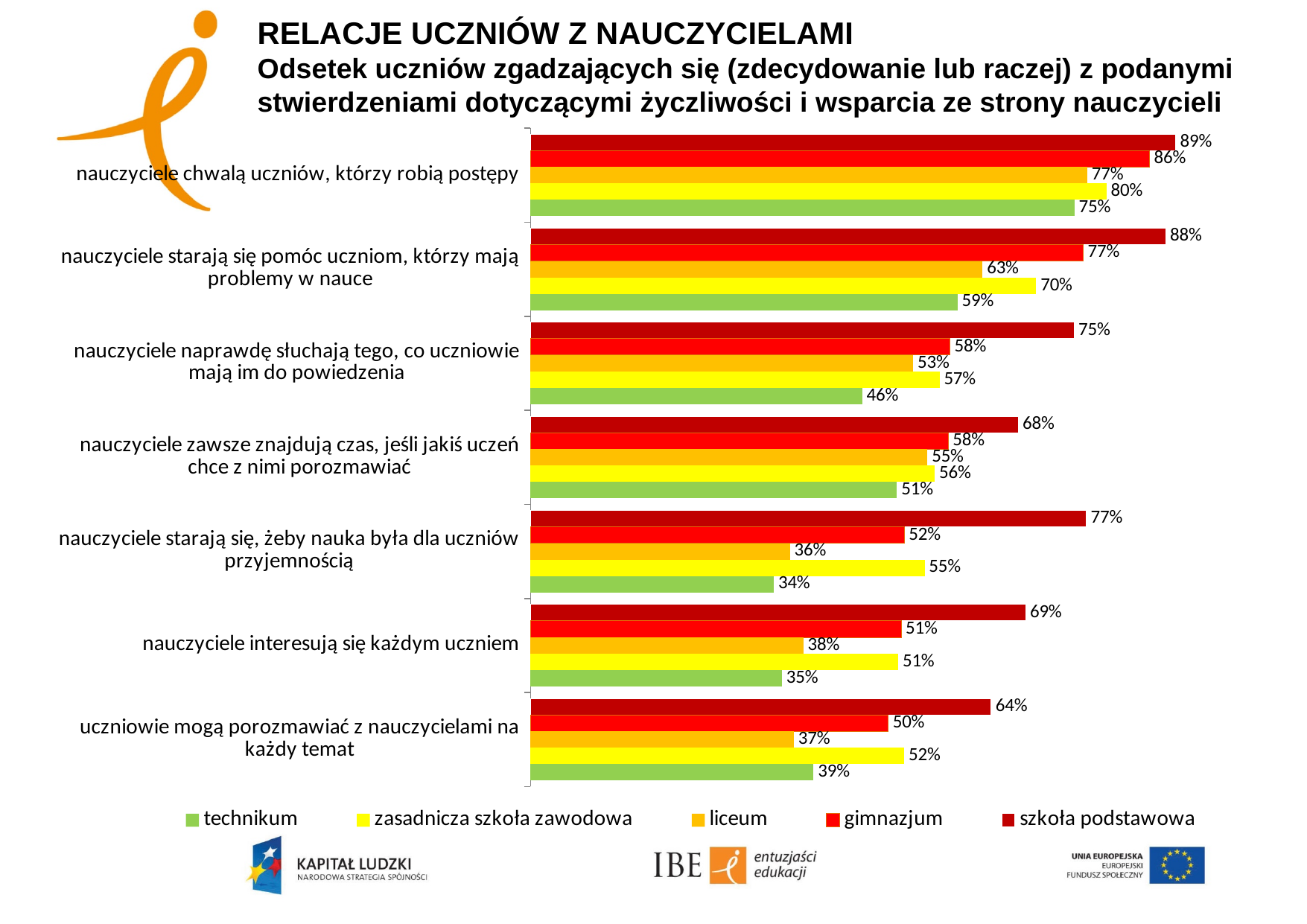
What kind of chart is shown on the slide? bar chart What is the value for technikum for the statement "nauczyciele starają się, żeby nauka była dla uczniów przyjemnością"? 34% What percentage of szkoła podstawowa students agree that "nauczyciele chwalą uczniów, którzy robią postępy"? 89% For the statement "nauczyciele zawsze znajdują czas, jeśli jakiś uczeń chce z nimi porozmawiać", which is larger: the value for gimnazjum or for technikum? gimnazjum What is the difference between the szkoła podstawowa and gimnazjum values for "nauczyciele starają się pomóc uczniom, którzy mają problemy w nauce"? 11 percentage points Which colour represents zasadnicza szkoła zawodowa in the legend? yellow For the statement "nauczyciele naprawdę słuchają tego, co uczniowie mają im do powiedzenia", which school type has the lowest value? technikum How many series does the legend list? 5 How many statements (categories) are shown on the chart? 7 What is the difference between the zasadnicza szkoła zawodowa and liceum values for "nauczyciele starają się, żeby nauka była dla uczniów przyjemnością"? 19 percentage points What is the value for liceum for the statement "uczniowie mogą porozmawiać z nauczycielami na każdy temat"? 37% For the statement "nauczyciele interesują się każdym uczniem", which school type has the highest value? szkoła podstawowa